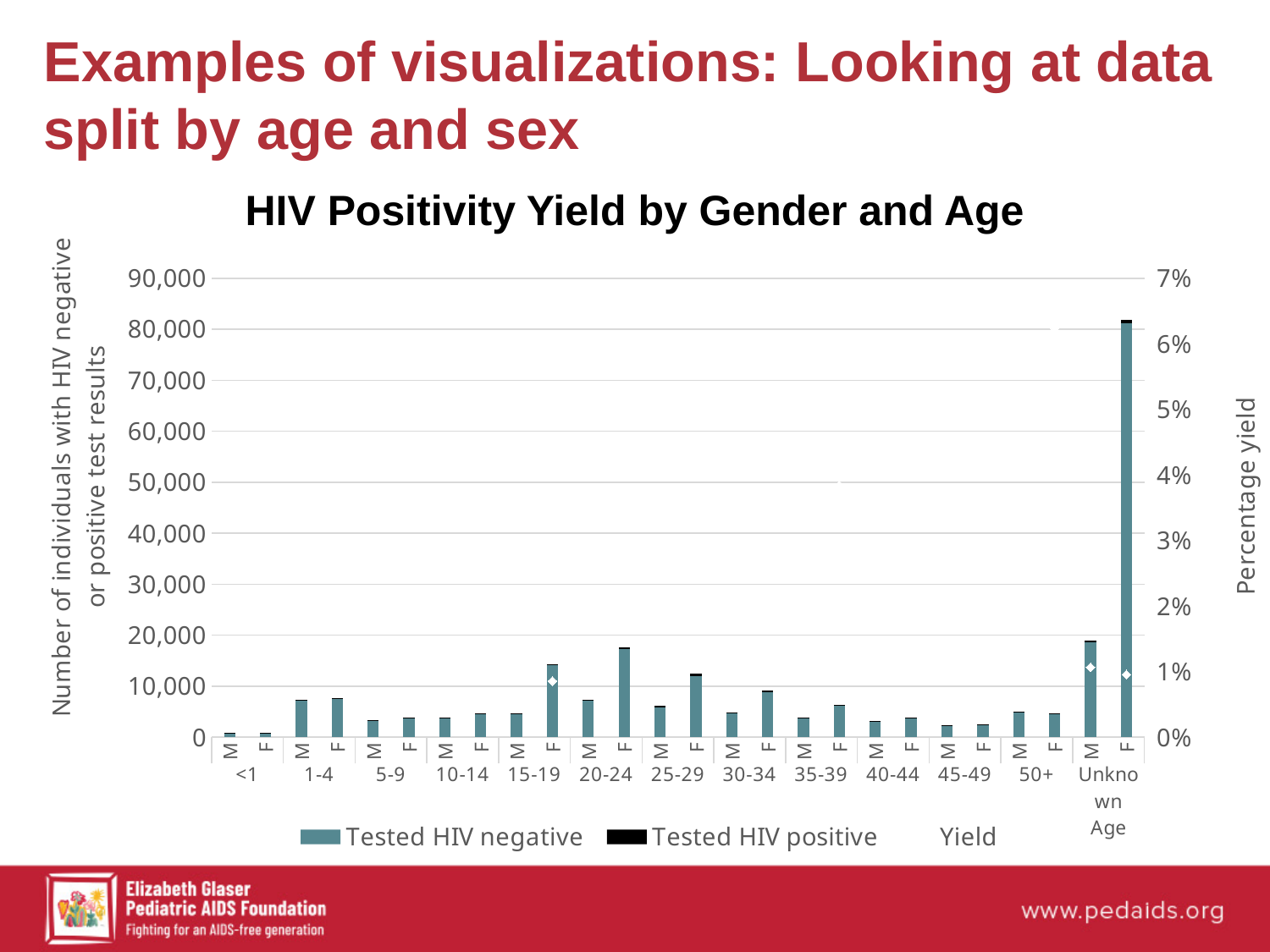
How many age groups are shown along the x axis of the chart? 13 Is the bar for Unknown Age F greater or less than 50,000? greater Which age group and sex has the tallest bar in the chart? Unknown Age, F Which bar is taller in the 15-19 age group, M or F? F What kind of chart is shown on the slide? combination bar and line chart Is the bar for 20-24 F greater or less than 10,000? greater How many series does the chart legend list? 3 Is the bar for <1 M greater or less than 10,000? less What is the title of the chart? HIV Positivity Yield by Gender and Age Which bar is taller in the 20-24 age group, M or F? F What is the label of the right-hand vertical axis of the chart? Percentage yield